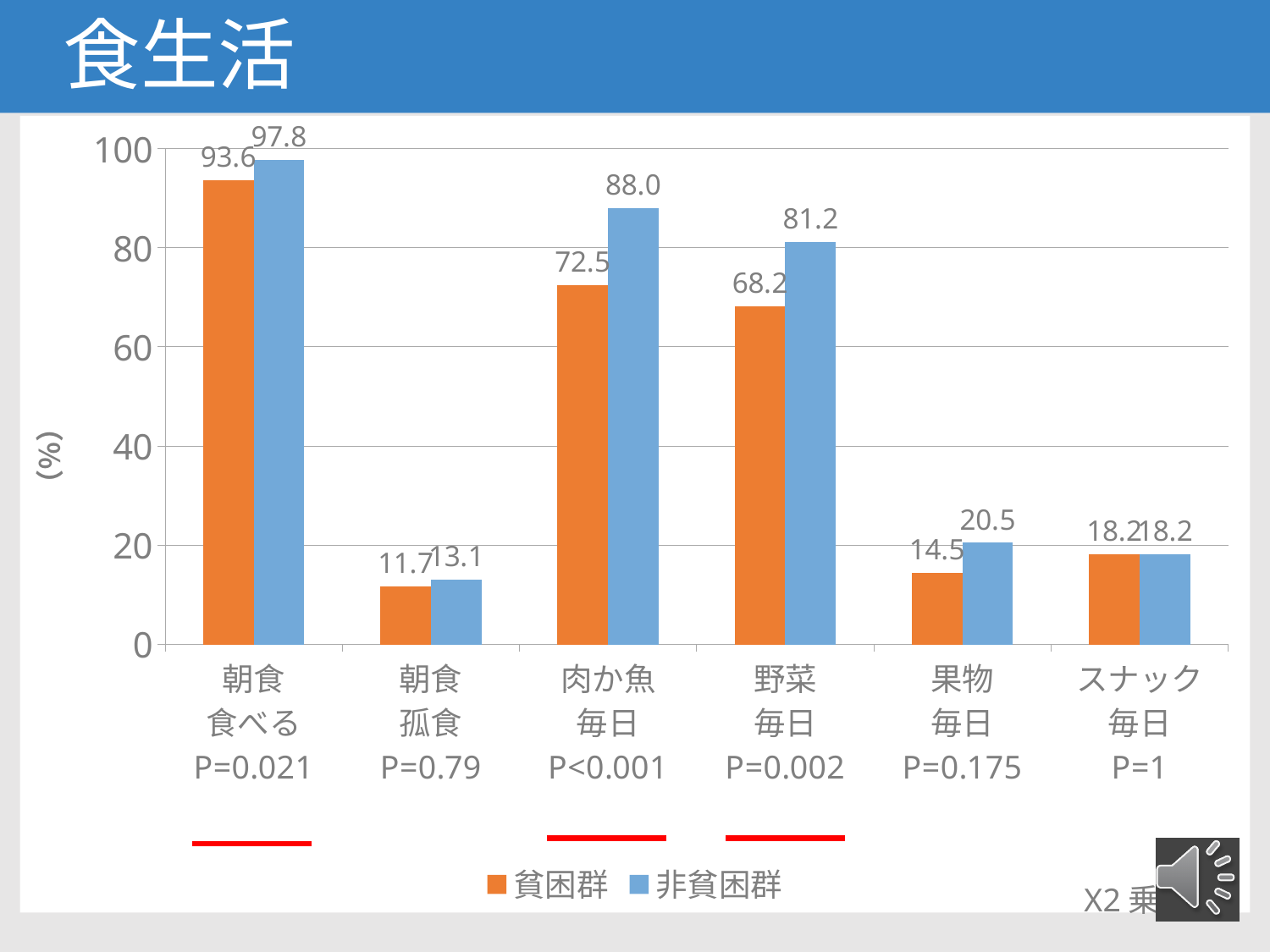
How many categories are shown on the x axis? 6 Which category has the highest value for 非貧困群? 朝食食べる What P value is shown under the 肉か魚毎日 category? P<0.001 How many series does the legend list? 2 Which is larger in the 野菜毎日 category, 貧困群 or 非貧困群? 非貧困群 What is the value for 貧困群 in the 朝食食べる category? 93.6 Which category has the lowest value for 貧困群? 朝食孤食 What is the difference between 非貧困群 and 貧困群 in the 肉か魚毎日 category? 15.5 What is the value for 非貧困群 in the 果物毎日 category? 20.5 What is the value for 非貧困群 in the 肉か魚毎日 category? 88.0 What is the value for 貧困群 in the 野菜毎日 category? 68.2 What kind of chart is shown on the slide? bar chart